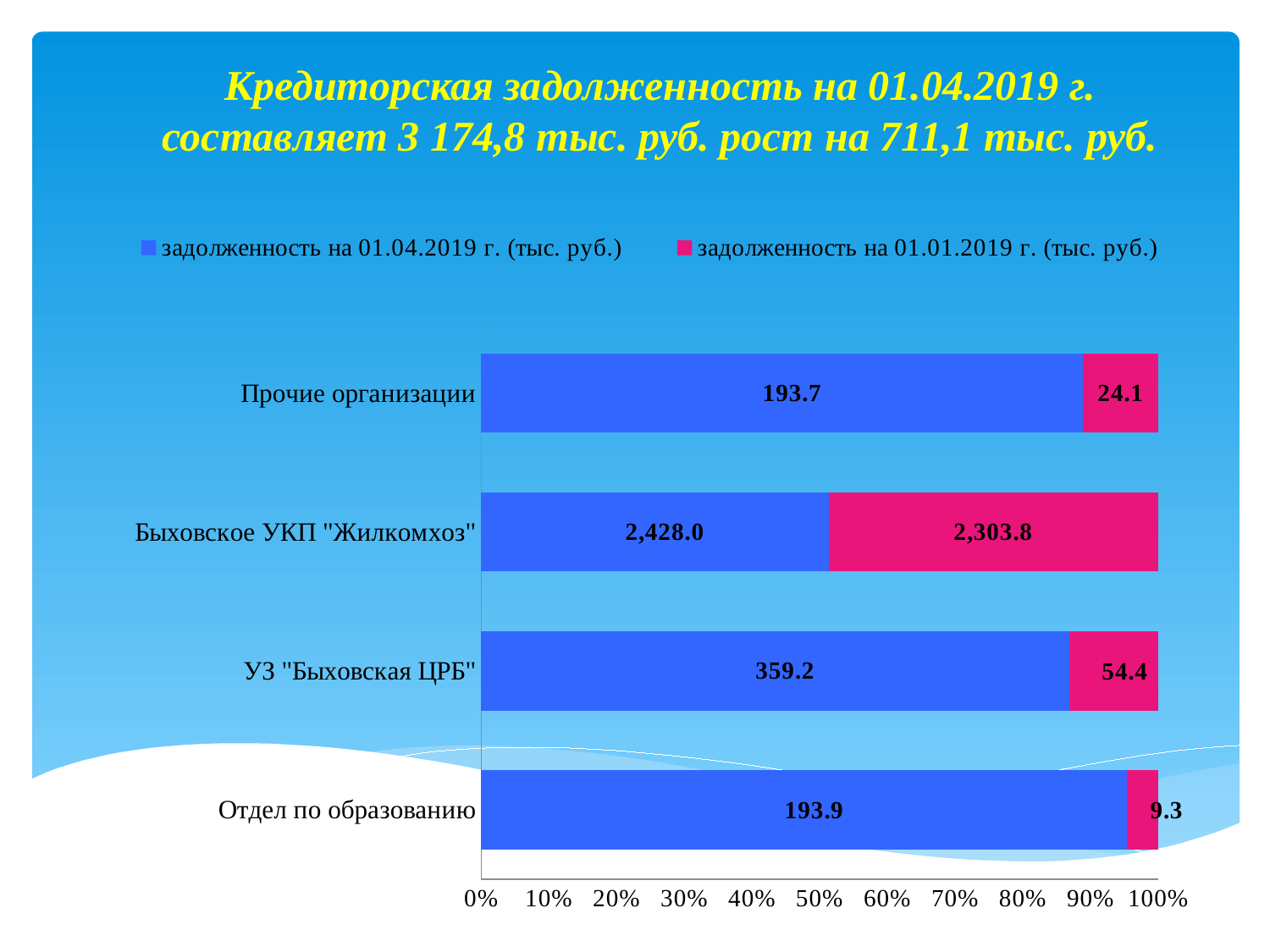
What is the value for Прочие организации in the series задолженность на 01.01.2019 г. (тыс. руб.)? 24.1 How many series does the legend list? 2 What is the difference between the 01.04.2019 and 01.01.2019 values for Быховское УКП "Жилкомхоз"? 124.2 What is the value for Отдел по образованию in the series задолженность на 01.04.2019 г. (тыс. руб.)? 193.9 What kind of chart is shown on the slide? Stacked bar chart What is the difference between the 01.04.2019 and 01.01.2019 values for УЗ "Быховская ЦРБ"? 304.8 How many categories are shown on the chart? 4 What is the value for УЗ "Быховская ЦРБ" in the series задолженность на 01.01.2019 г. (тыс. руб.)? 54.4 Which category has the lowest value in the series задолженность на 01.01.2019 г. (тыс. руб.)? Отдел по образованию Which is larger: the 01.04.2019 value for УЗ "Быховская ЦРБ" or the 01.04.2019 value for Отдел по образованию? УЗ "Быховская ЦРБ" What is the value for Быховское УКП "Жилкомхоз" in the series задолженность на 01.04.2019 г. (тыс. руб.)? 2,428.0 Which category has the highest value in the series задолженность на 01.04.2019 г. (тыс. руб.)? Быховское УКП "Жилкомхоз"